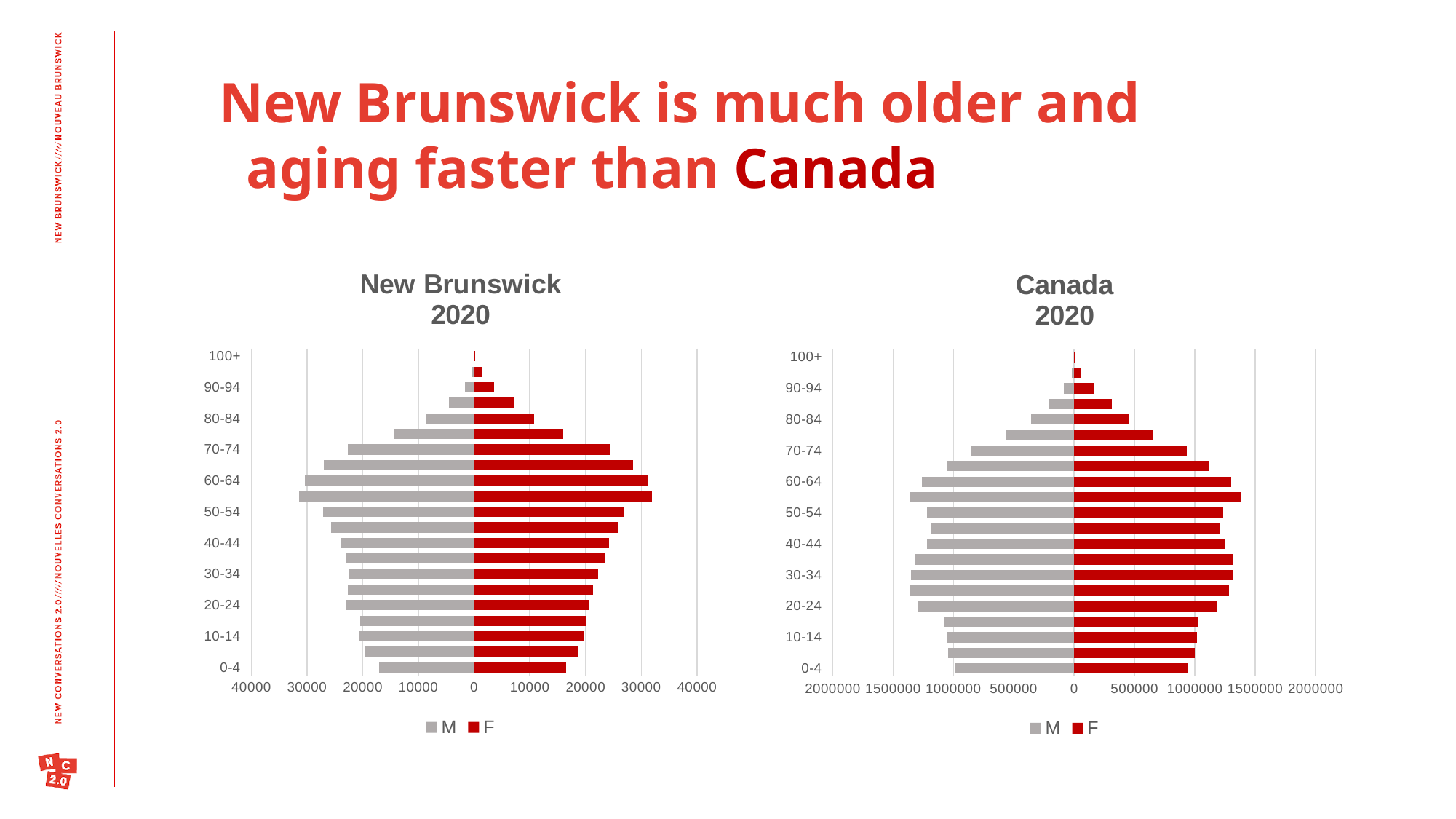
What are the two legend entries on the New Brunswick 2020 chart? M and F What kind of chart is the New Brunswick 2020 chart? bar chart How many series does the legend of the Canada 2020 chart list? 2 How many age-group labels are shown on the vertical axis of the New Brunswick 2020 chart? 11 In the New Brunswick 2020 chart, which age group has the smallest F bar? 100+ In the Canada 2020 chart, which colour represents the F series? red In the New Brunswick 2020 chart, which is larger: the M bar for 60-64 or the M bar for 80-84? 60-64 In the New Brunswick 2020 chart, is the M value for 0-4 greater or less than 20000? less In the Canada 2020 chart, is the F value for 60-64 greater or less than 1000000? greater In the Canada 2020 chart, which age group has the smallest M bar? 100+ In the Canada 2020 chart, do the F bars get longer or shorter going from 60-64 up to 100+? shorter In the New Brunswick 2020 chart, is the F value for 70-74 greater or less than 20000? greater